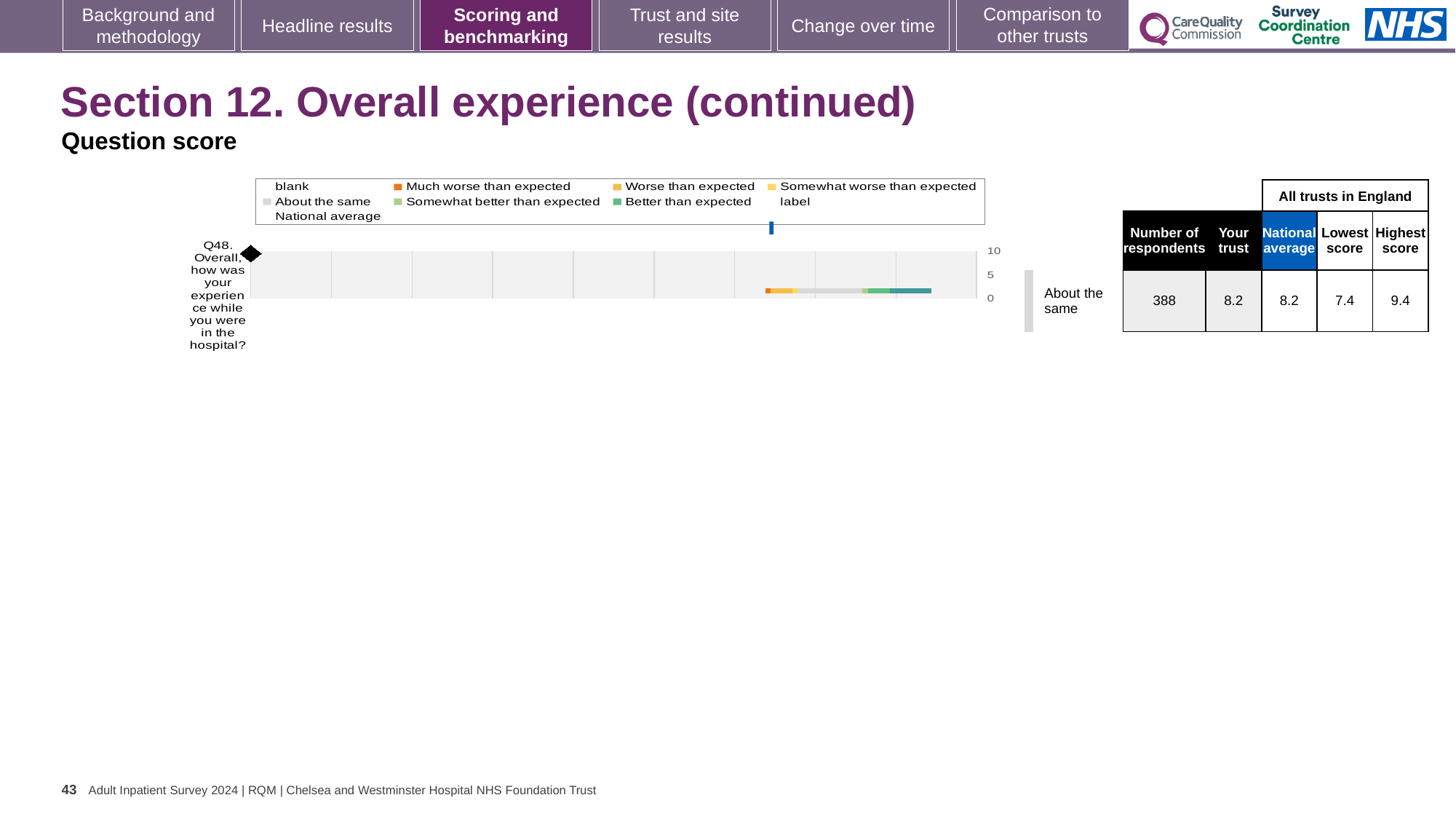
What is the difference between the highest score and the lowest score for Q48 in the table beside the chart? 2.0 How many survey questions are plotted in the chart? 1 In the table beside the chart, what is the lowest score among all trusts in England for Q48? 7.4 In the table beside the chart, what is the highest score among all trusts in England for Q48? 9.4 Which benchmark category is shown next to the Q48 bar? About the same In the table beside the chart, what is the 'Your trust' score for Q48? 8.2 Which question is plotted in the chart? Q48. Overall, how was your experience while you were in the hospital? In the table beside the chart, what is the number of respondents for Q48? 388 What is the difference between the 'Your trust' score and the national average for Q48 in the table beside the chart? 0 In the table beside the chart, what is the national average score for Q48? 8.2 What kind of chart is shown for Q48 on the slide? bar chart